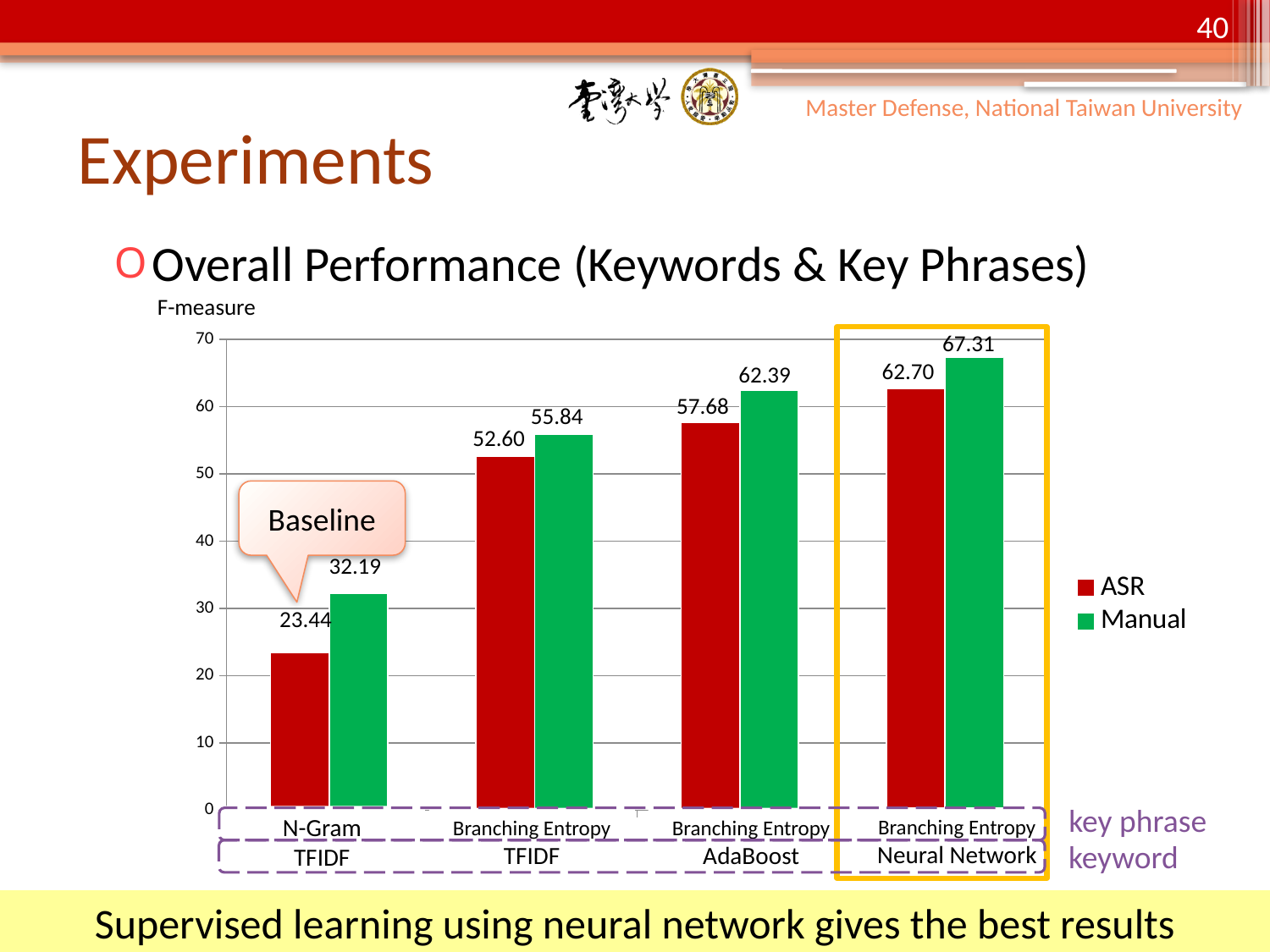
How many categories are shown on the x axis of the chart? 4 Do the ASR values rise or fall from left to right across the categories? Rise Which category has the lowest ASR F-measure? N-Gram / TFIDF Which is larger for the Branching Entropy / AdaBoost category, the ASR value or the Manual value? Manual Which category has the highest Manual F-measure? Branching Entropy / Neural Network What is the ASR value for the Branching Entropy / TFIDF category? 52.60 What is the Manual F-measure for the Branching Entropy / Neural Network category? 67.31 What kind of chart is shown on the slide? Bar chart How many series does the chart legend list? 2 What is the Manual value for the Branching Entropy / AdaBoost category? 62.39 What is the ASR F-measure for the N-Gram / TFIDF category? 23.44 What is the difference between the Manual and ASR values for the Branching Entropy / Neural Network category? 4.61